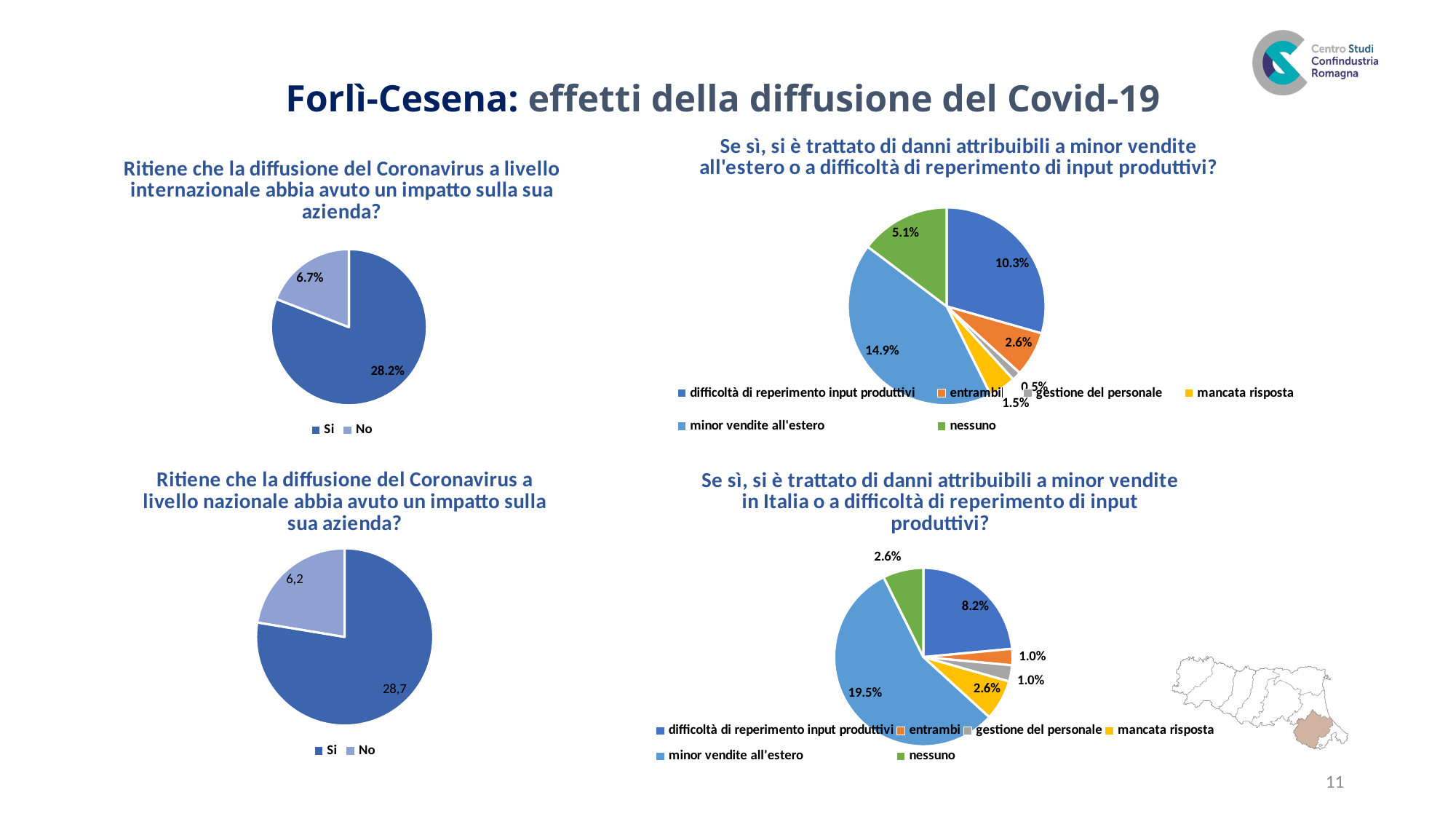
In the top-right pie chart (danni attribuibili a minor vendite all'estero), what value is shown for 'minor vendite all'estero'? 14.9% In the top-right pie chart (danni attribuibili a minor vendite all'estero), which category has the smallest slice? gestione del personale In the bottom-left pie chart (impact of Coronavirus at national level), what value is shown for 'No'? 6,2 In the top-left pie chart (impact of Coronavirus at international level), what value is shown for 'Si'? 28.2% In the bottom-right pie chart (danni attribuibili a minor vendite in Italia), which is larger: 'mancata risposta' or 'entrambi'? mancata risposta In the bottom-right pie chart (danni attribuibili a minor vendite in Italia), what value is shown for 'difficoltà di reperimento input produttivi'? 8.2% In the bottom-left pie chart (impact of Coronavirus at national level), what value is shown for 'Si'? 28,7 What type of chart is the bottom-left chart (impact of Coronavirus at national level)? pie chart In the top-right pie chart (danni attribuibili a minor vendite all'estero), what is the difference between 'minor vendite all'estero' and 'difficoltà di reperimento input produttivi'? 4.6% In the bottom-right pie chart (danni attribuibili a minor vendite in Italia), which category has the largest slice? minor vendite all'estero How many categories does the legend of the top-right pie chart (danni attribuibili a minor vendite all'estero) list? 6 In the top-left pie chart (impact of Coronavirus at international level), what value is shown for 'No'? 6.7%